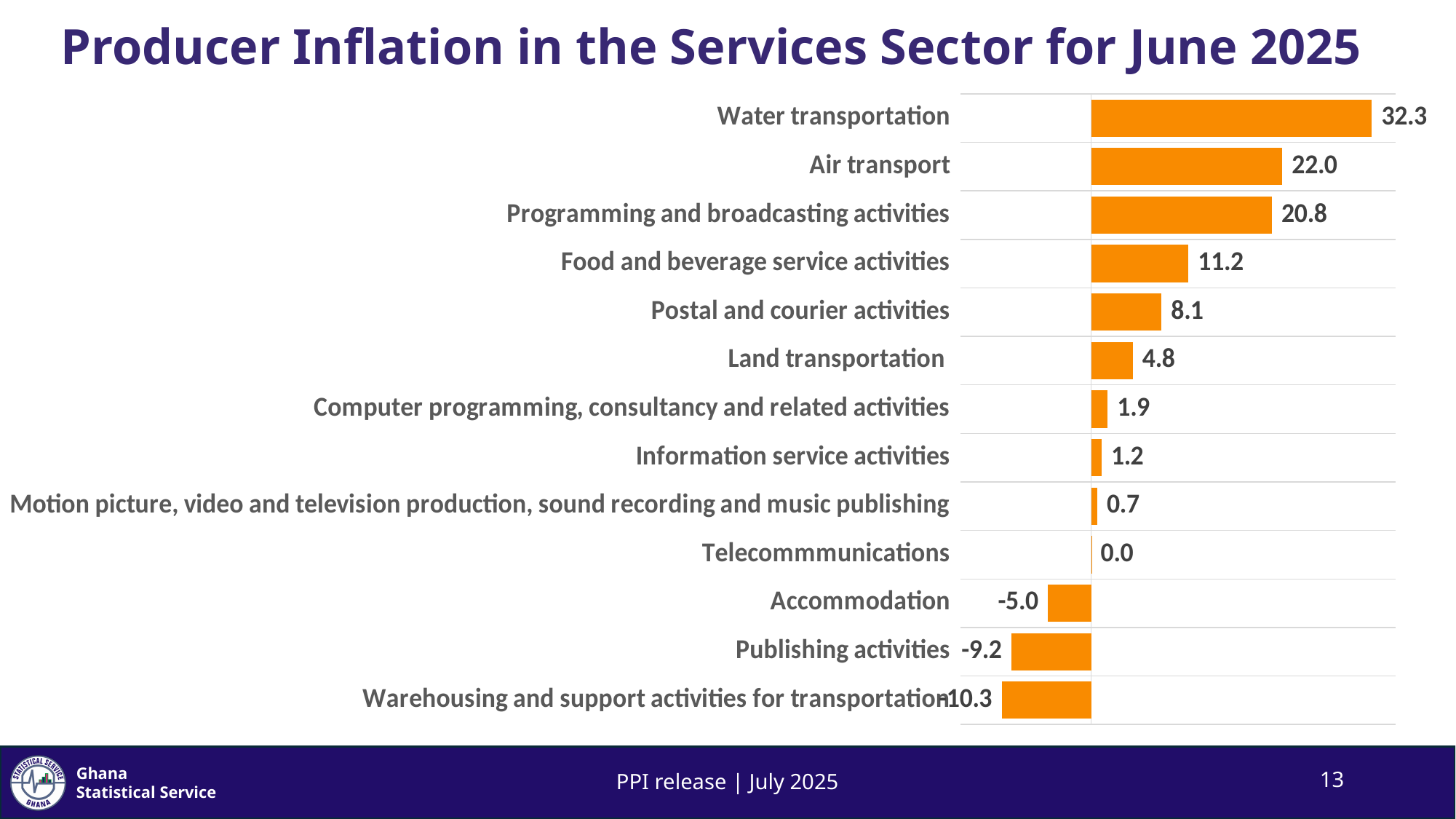
What is the value for Telecommmunications? 0.0 What is the value for Accommodation? -5.0 Which is larger, the value for Land transportation or the value for Information service activities? Land transportation How many categories are shown in the chart? 13 What is the value for Water transportation? 32.3 What is the difference between the values for Air transport and Programming and broadcasting activities? 1.2 Which category has the highest value? Water transportation What is the value for Postal and courier activities? 8.1 How many categories have a negative value? 3 Which category has the lowest value? Warehousing and support activities for transportation What is the difference between the values for Water transportation and Food and beverage service activities? 21.1 What kind of chart is shown on the slide? Bar chart